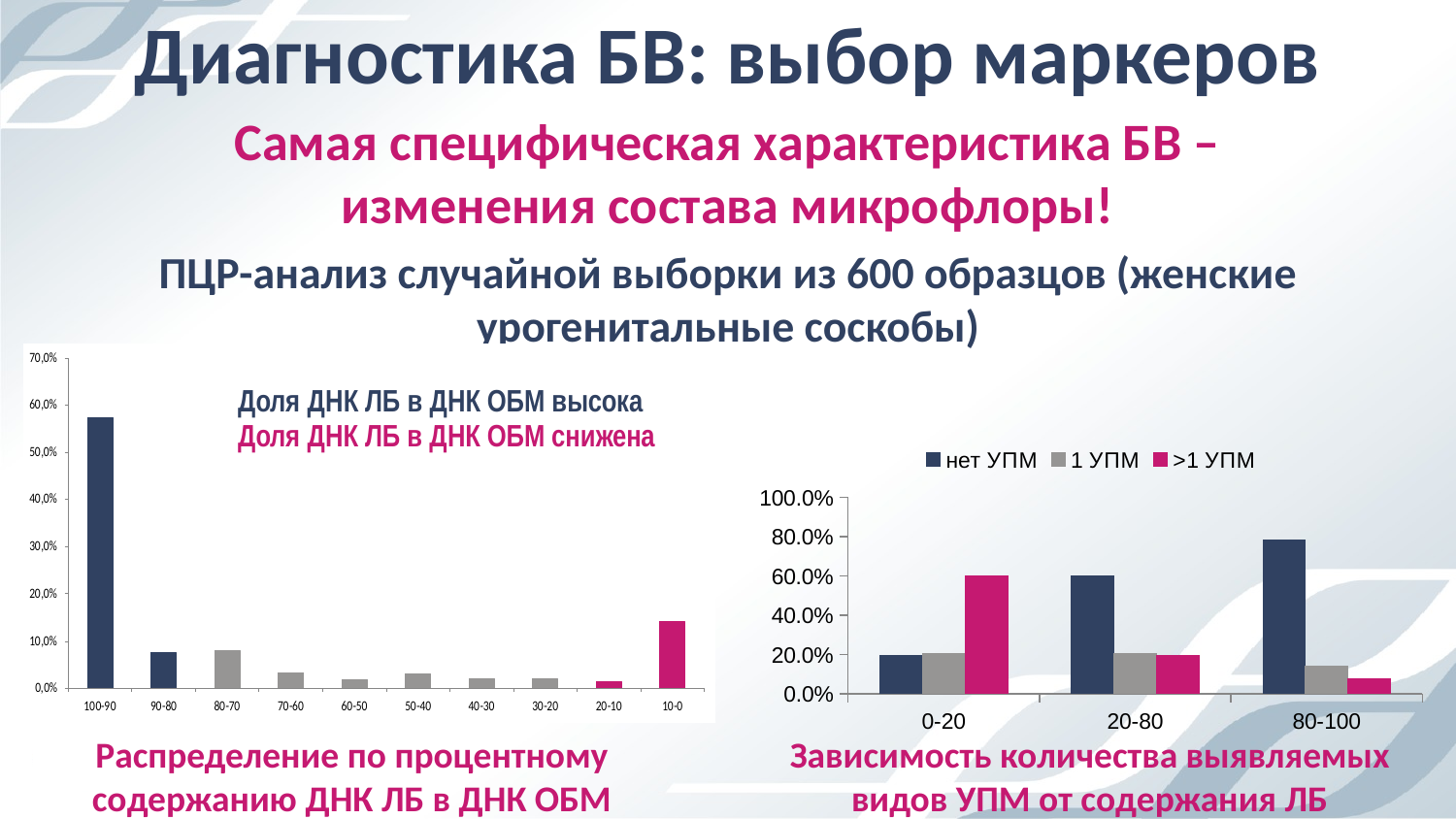
On the right chart (Зависимость количества выявляемых видов УПМ от содержания ЛБ), in which category is the >1 УПМ series lowest? 80-100 On the right chart (Зависимость количества выявляемых видов УПМ от содержания ЛБ), which series is larger for 0-20: нет УПМ or >1 УПМ? >1 УПМ What kind of chart is the left chart (Распределение по процентному содержанию ДНК ЛБ в ДНК ОБМ)? bar chart On the right chart (Зависимость количества выявляемых видов УПМ от содержания ЛБ), is the value of нет УПМ for 80-100 greater or less than 60.0%? greater On the left chart (Распределение по процентному содержанию ДНК ЛБ в ДНК ОБМ), which category has the highest value? 100-90 On the left chart (Распределение по процентному содержанию ДНК ЛБ в ДНК ОБМ), is the value for 10-0 greater or less than 10,0%? greater On the left chart (Распределение по процентному содержанию ДНК ЛБ в ДНК ОБМ), is the value for 100-90 greater or less than 50,0%? greater On the left chart (Распределение по процентному содержанию ДНК ЛБ в ДНК ОБМ), which is larger: the value for 10-0 or the value for 90-80? 10-0 On the right chart (Зависимость количества выявляемых видов УПМ от содержания ЛБ), how many series does the legend list? 3 On the right chart (Зависимость количества выявляемых видов УПМ от содержания ЛБ), in which category is the нет УПМ series highest? 80-100 On the left chart (Распределение по процентному содержанию ДНК ЛБ в ДНК ОБМ), how many categories are shown on the x axis? 10 On the right chart (Зависимость количества выявляемых видов УПМ от содержания ЛБ), how many categories are shown on the x axis? 3